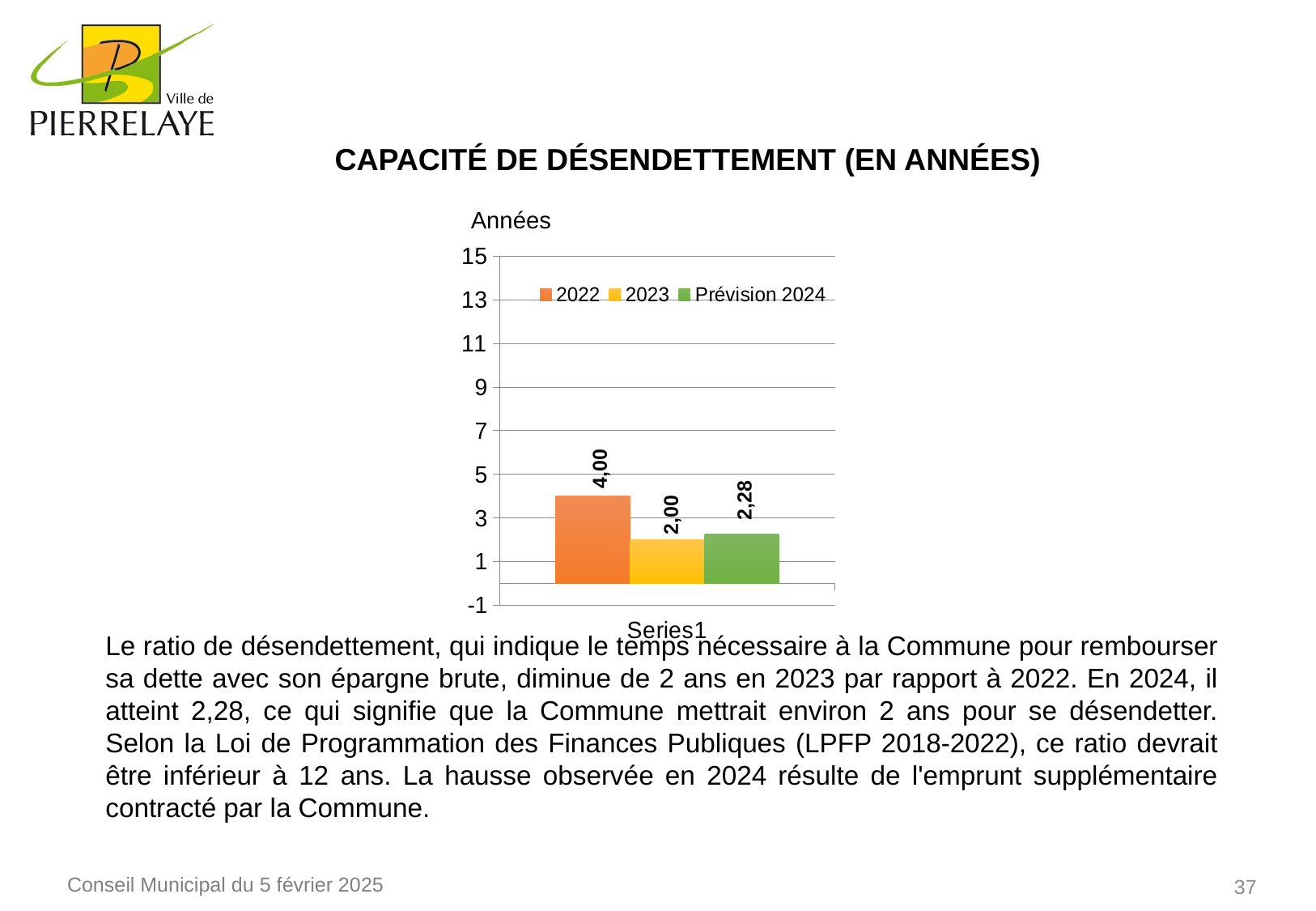
Which is larger, the value for 2022 or the value for Prévision 2024? 2022 How many series does the legend list? 3 What is the difference between the values for 2022 and 2023? 2,00 What is the difference between the values for Prévision 2024 and 2023? 0,28 Which series has the highest value in the chart? 2022 What is the value for 2022 in the chart? 4,00 What is the value for Prévision 2024 in the chart? 2,28 What kind of chart is shown on the slide? bar chart What is the title of the chart? CAPACITÉ DE DÉSENDETTEMENT (EN ANNÉES) Is the value for 2022 greater or less than 3? greater Which series has the lowest value in the chart? 2023 What is the value for 2023 in the chart? 2,00